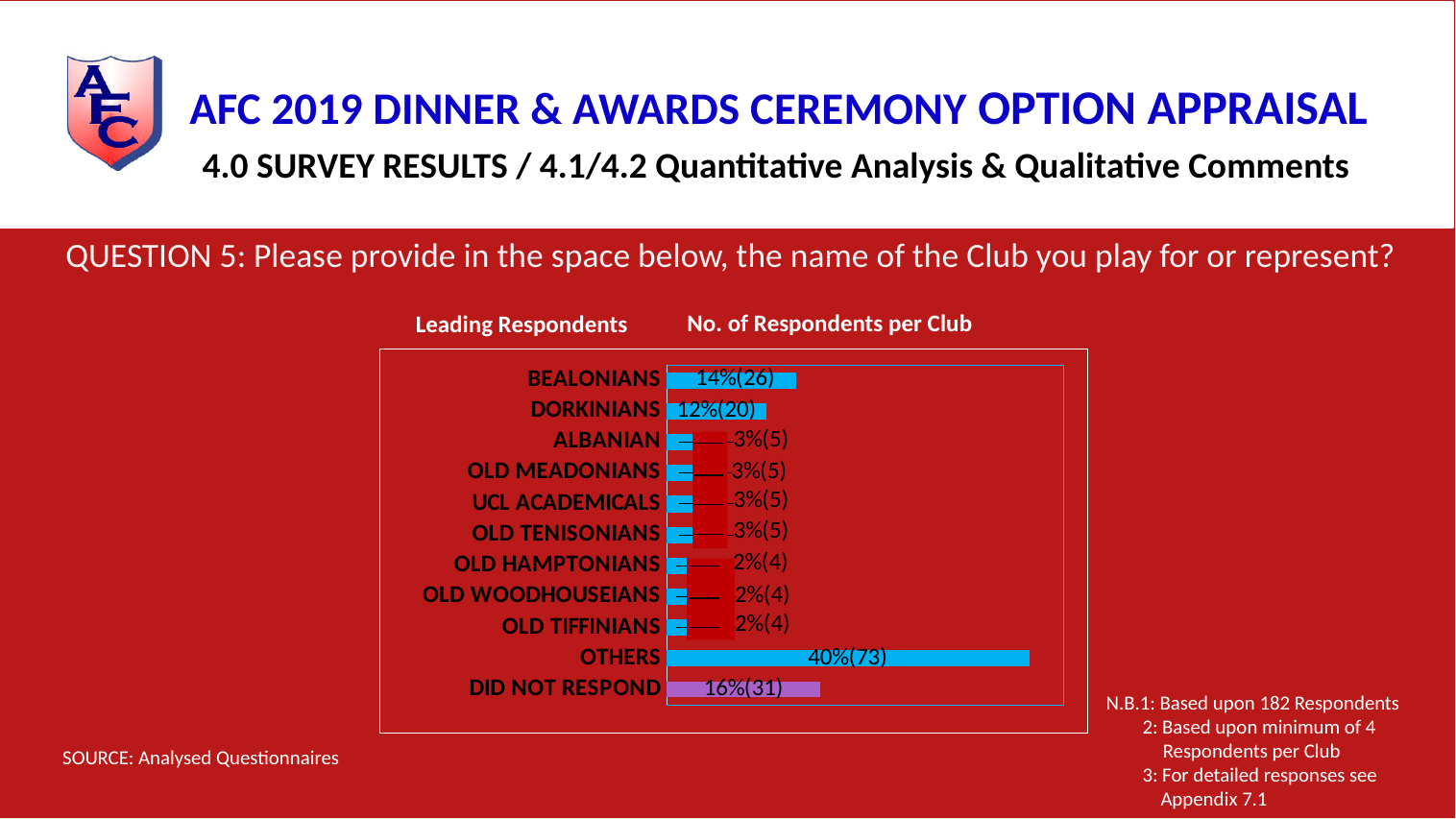
What is the data label shown for DID NOT RESPOND in the chart? 16%(31) What is the data label shown for BEALONIANS in the chart? 14%(26) How many more respondents does OTHERS have than BEALONIANS? 47 How many more respondents does BEALONIANS have than DORKINIANS? 6 What is the data label shown for OLD TIFFINIANS in the chart? 2%(4) Which has more respondents, DID NOT RESPOND or DORKINIANS? DID NOT RESPOND Which category has the highest value in the chart? OTHERS Which named club (excluding OTHERS and DID NOT RESPOND) has the most respondents? BEALONIANS What is the data label shown for DORKINIANS in the chart? 12%(20) How many categories are shown in the chart? 11 What type of chart is shown on the slide? Bar chart What is the title of the chart? No. of Respondents per Club